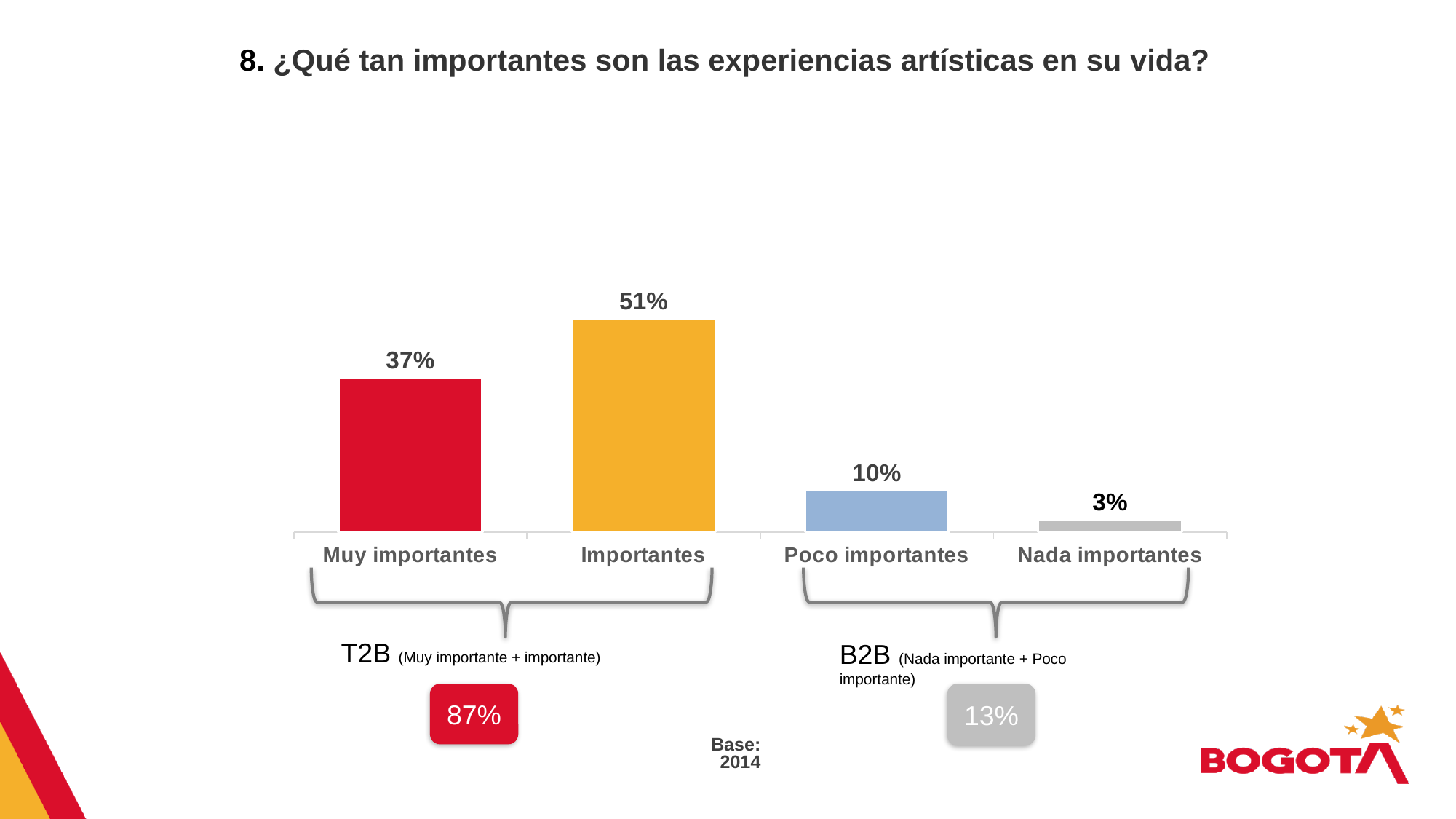
What is the difference between the values for Importantes and Muy importantes? 14% What is the value for Muy importantes? 37% Which category has the highest value? Importantes What is the B2B value (Nada importante + Poco importante) shown on the slide? 13% Which category has the lowest value? Nada importantes What is the value for Importantes? 51% What is the value for Poco importantes? 10% What kind of chart is shown on the slide? Bar chart How many categories are shown in the chart? 4 Which is larger, the value for Muy importantes or the value for Poco importantes? Muy importantes What is the value for Nada importantes? 3% What is the T2B value (Muy importante + importante) shown on the slide? 87%